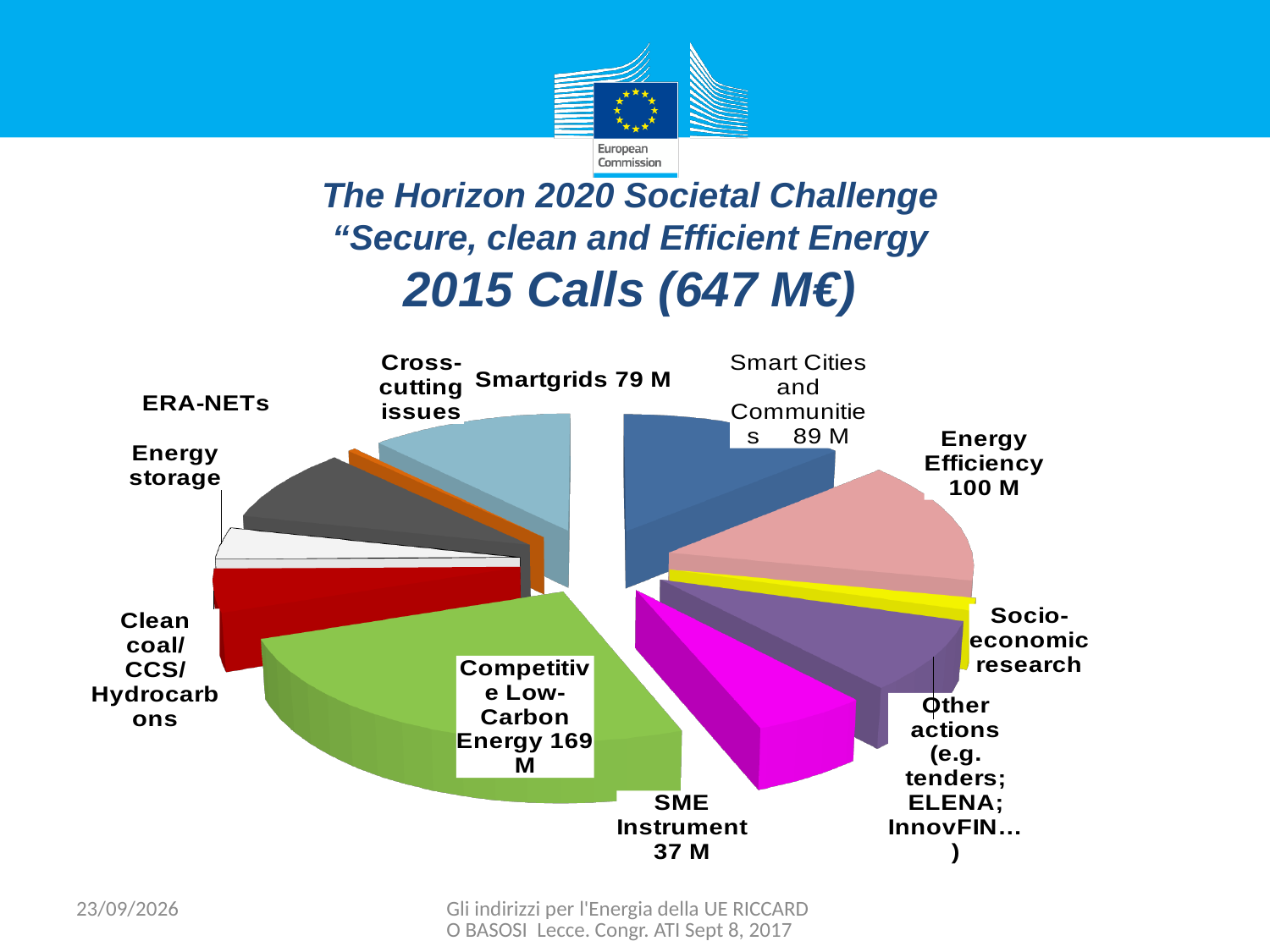
How many slices does the pie chart have? 11 What total amount is given in the chart title for the 2015 Calls? 647 M€ What is the difference between the values for Smart Cities and Communities and Smartgrids? 10 M What is the value shown for SME Instrument? 37 M What is the value shown for Competitive Low-Carbon Energy? 169 M Which is larger, the value for Smartgrids or the value for Smart Cities and Communities? Smart Cities and Communities What kind of chart is shown on the slide? Pie chart What is the difference between the values for Competitive Low-Carbon Energy and Energy Efficiency? 69 M Which slice of the pie chart is the largest? Competitive Low-Carbon Energy What is the value shown for Energy Efficiency? 100 M What is the value shown for Smart Cities and Communities? 89 M What is the value shown for Smartgrids? 79 M